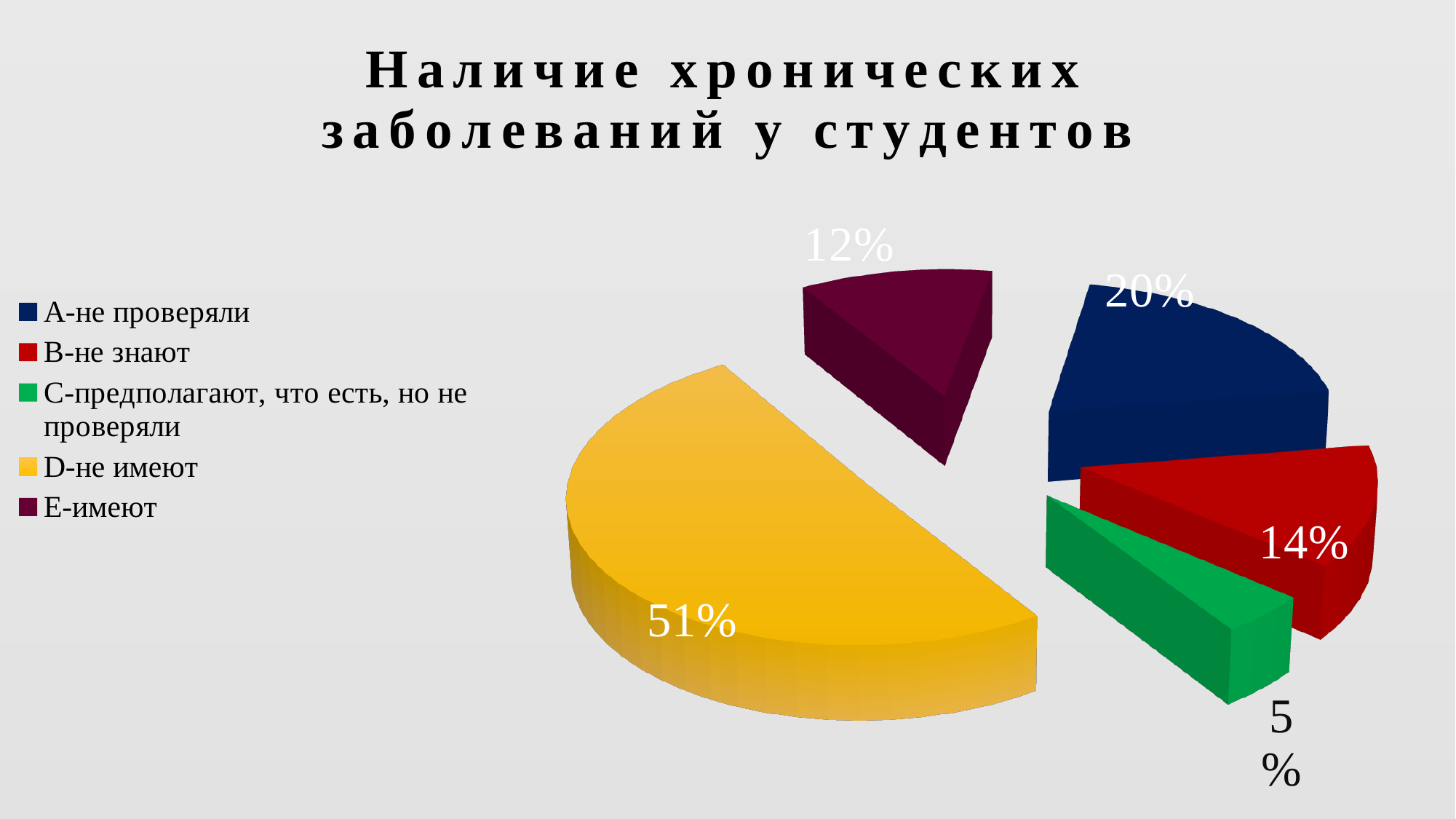
Which is larger, the value for B-не знают or the value for E-имеют? B-не знают How many categories does the pie chart have? 5 What kind of chart is shown on the slide? pie chart What is the value for A-не проверяли? 20% What is the value for E-имеют? 12% What is the value for B-не знают? 14% What is the difference between the values for A-не проверяли and B-не знают? 6% What is the title of the chart? Наличие хронических заболеваний у студентов What is the value for C-предполагают, что есть, но не проверяли? 5% Which category has the largest share of the pie? D-не имеют What is the value for D-не имеют? 51% Which category has the smallest share of the pie? C-предполагают, что есть, но не проверяли